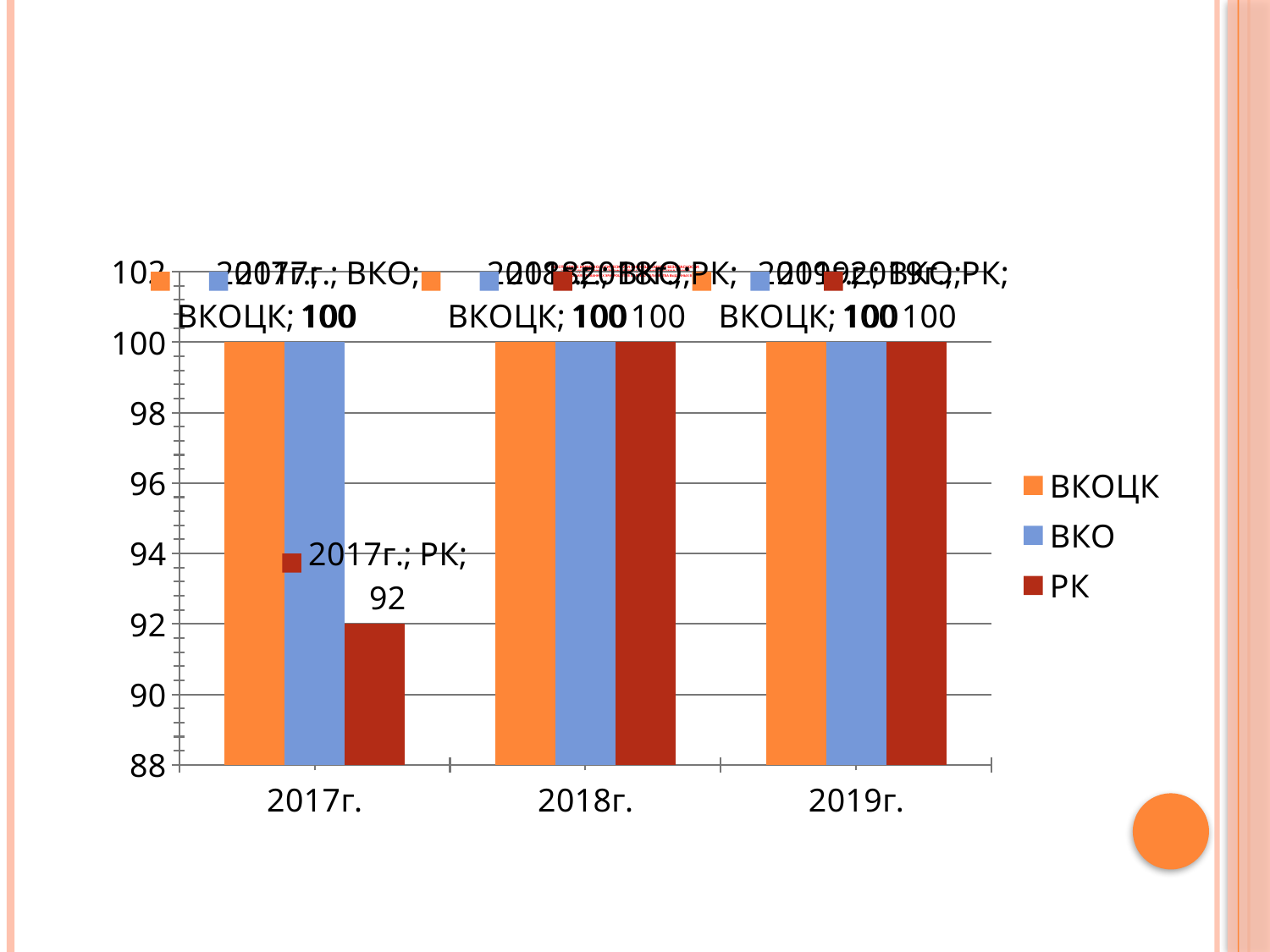
What is the value for РК in 2017г.? 92 What is the value for ВКОЦК in 2017г.? 100 What kind of chart is shown on the slide? bar chart How many series does the legend list? 3 What is the difference between the ВКОЦК value and the РК value in 2017г.? 8 Which series is shown in orange in the legend? ВКОЦК How many year categories are shown on the x axis? 3 What is the value for РК in 2018г.? 100 Does the value for РК rise or fall from 2017г. to 2018г.? rise Which series has the lowest value in 2017г.? РК Is the value for РК in 2017г. greater or less than 94? less Which is larger in 2017г., the value for ВКО or the value for РК? ВКО